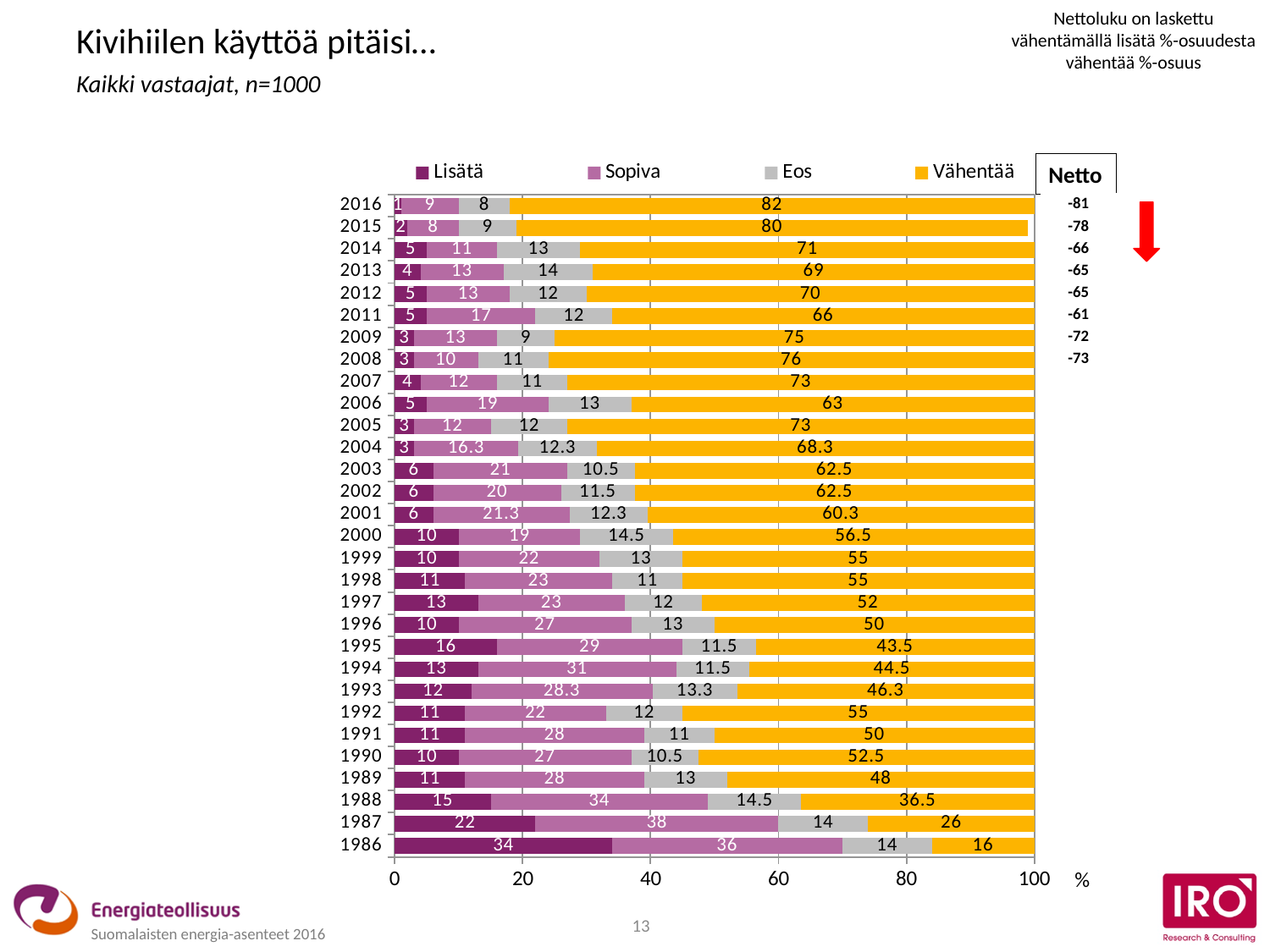
What is the Netto value shown for 2016? -81 How many series does the legend list? 4 Which year has the highest Vähentää value? 2016 What is the Eos value for 1988? 14.5 What is the Vähentää value for 2016? 82 How many years are shown in the chart? 30 What kind of chart is shown on the slide? Stacked bar chart Which year has the highest Lisätä value? 1986 Which is larger, the Sopiva value for 1987 or for 1986? 1987 Which year has the lowest Vähentää value? 1986 What is the difference between the Vähentää values for 2016 and 2015? 2 What is the Lisätä value for 1986? 34